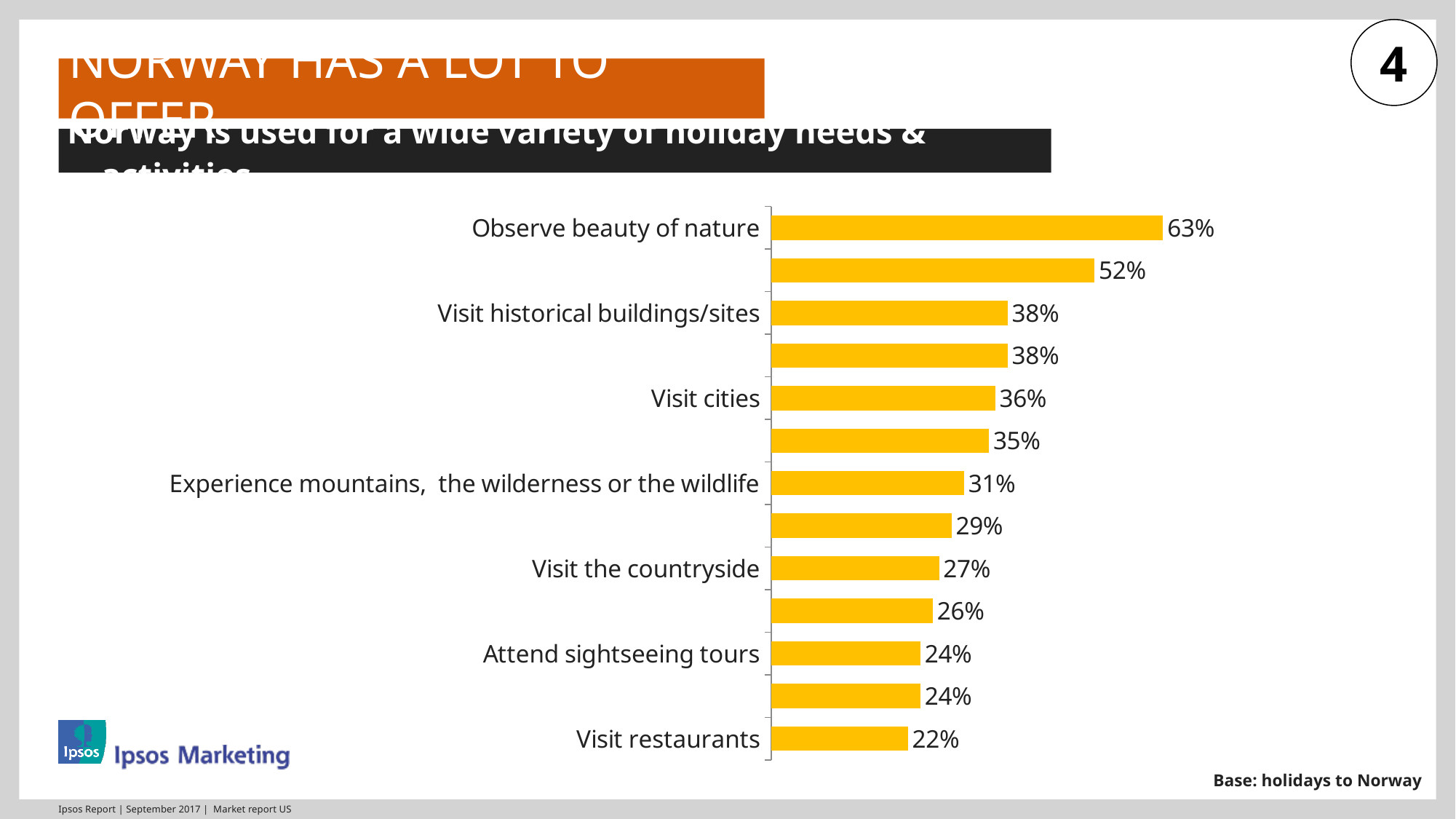
What is the value for Attend sightseeing tours? 24% What is the value for Visit historical buildings/sites? 38% What is the value for Visit cities? 36% What is the value for Experience mountains, the wilderness or the wildlife? 31% What is the difference between the values for Observe beauty of nature and Visit cities? 27% What is the value for Visit the countryside? 27% What kind of chart is shown on the slide? bar chart Which category has the lowest value? Visit restaurants Which category has the highest value? Observe beauty of nature What is the value for Visit restaurants? 22% Which is larger, the value for Visit the countryside or the value for Attend sightseeing tours? Visit the countryside What is the value for Observe beauty of nature? 63%